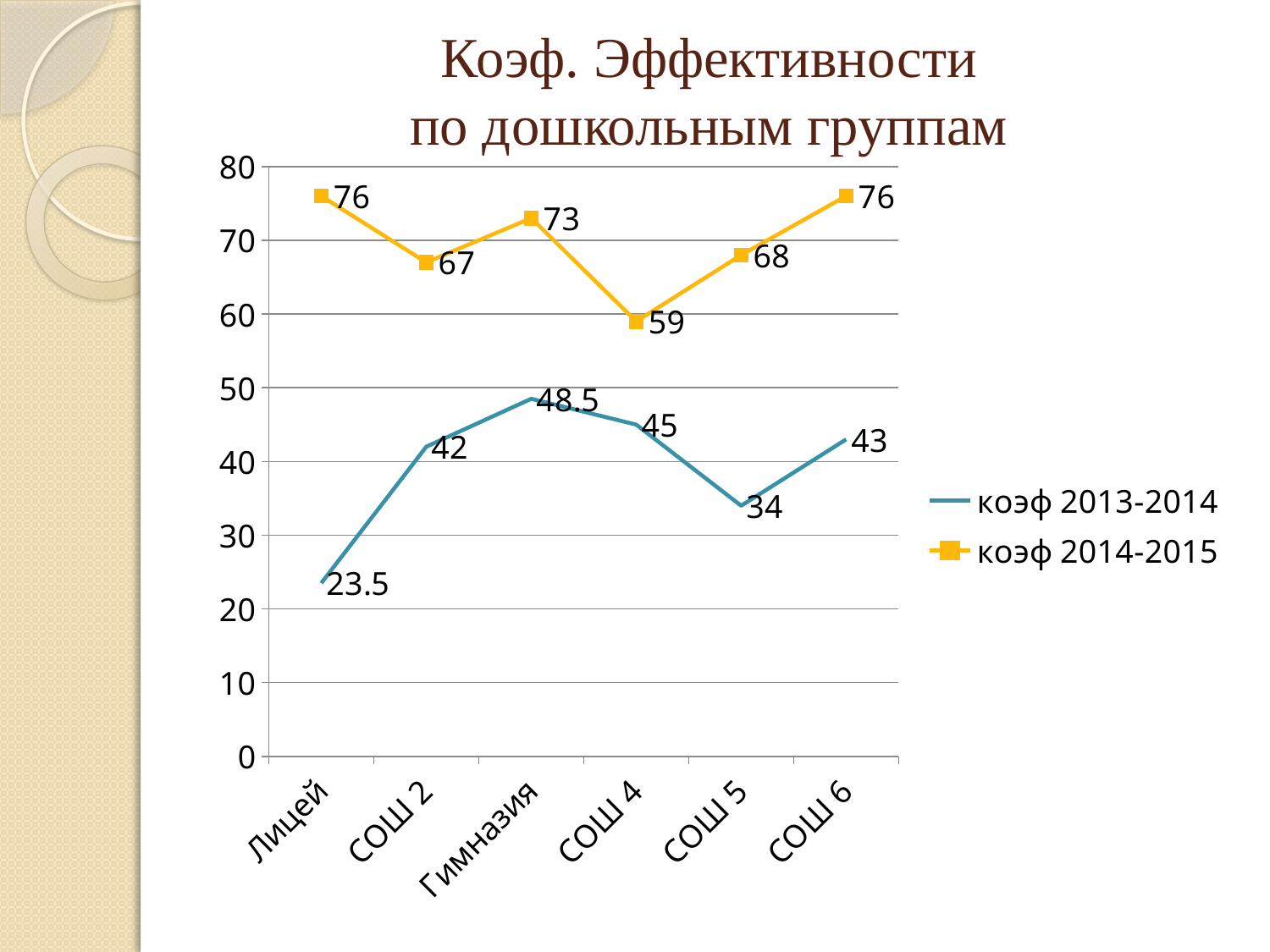
Which category has the lowest value in the коэф 2014-2015 series? СОШ 4 What is the value for Лицей in the коэф 2013-2014 series? 23.5 How many categories are shown on the x axis? 6 Which category has the highest value in the коэф 2013-2014 series? Гимназия What is the value for СОШ 4 in the коэф 2014-2015 series? 59 What kind of chart is shown on the slide? Line chart What is the difference between the коэф 2014-2015 and коэф 2013-2014 values for СОШ 5? 34 Which category has the lowest value in the коэф 2013-2014 series? Лицей What is the title of the chart? Коэф. Эффективности по дошкольным группам What is the value for Гимназия in the коэф 2013-2014 series? 48.5 Which is larger for СОШ 2: the коэф 2013-2014 value or the коэф 2014-2015 value? коэф 2014-2015 How many series does the legend list? 2